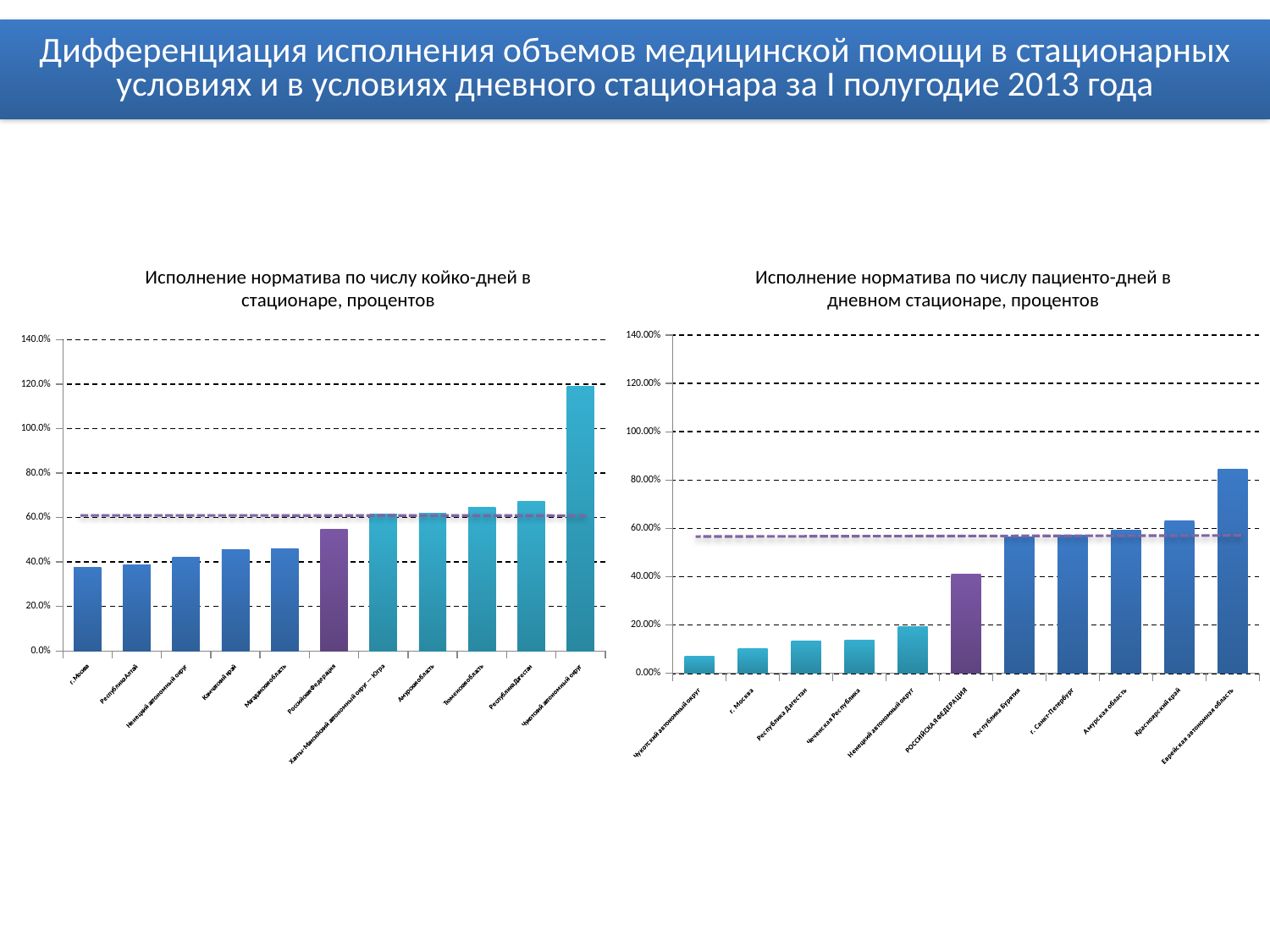
How many categories (bars) are plotted on the right chart about пациенто-дней в дневном стационаре? 11 How many categories (bars) are plotted on the left chart about койко-дней в стационаре? 11 On the left chart (койко-дней в стационаре), which category has the lowest value? г. Москва On the left chart (койко-дней в стационаре), which category has the highest value? Чукотский автономный округ What kind of chart is the left chart, 'Исполнение нормативa по числу койко-дней в стационаре, процентов'? bar chart On the right chart (пациенто-дней в дневном стационаре), which category has the highest value? Еврейская автономная область On the right chart (пациенто-дней в дневном стационаре), is the value for Еврейская автономная область greater or less than 80.00%? greater On the left chart (койко-дней в стационаре), is the value for Российская Федерация greater or less than 60.0%? less On the right chart (пациенто-дней в дневном стационаре), do the bar values rise or fall from left to right along the x axis? rise On the left chart (койко-дней в стационаре), is the value for Чукотский автономный округ greater or less than 100.0%? greater On the right chart (пациенто-дней в дневном стационаре), which category has the lowest value? Чукотский автономный округ What is the title of the right chart on the slide? Исполнение норматива по числу пациенто-дней в дневном стационаре, процентов